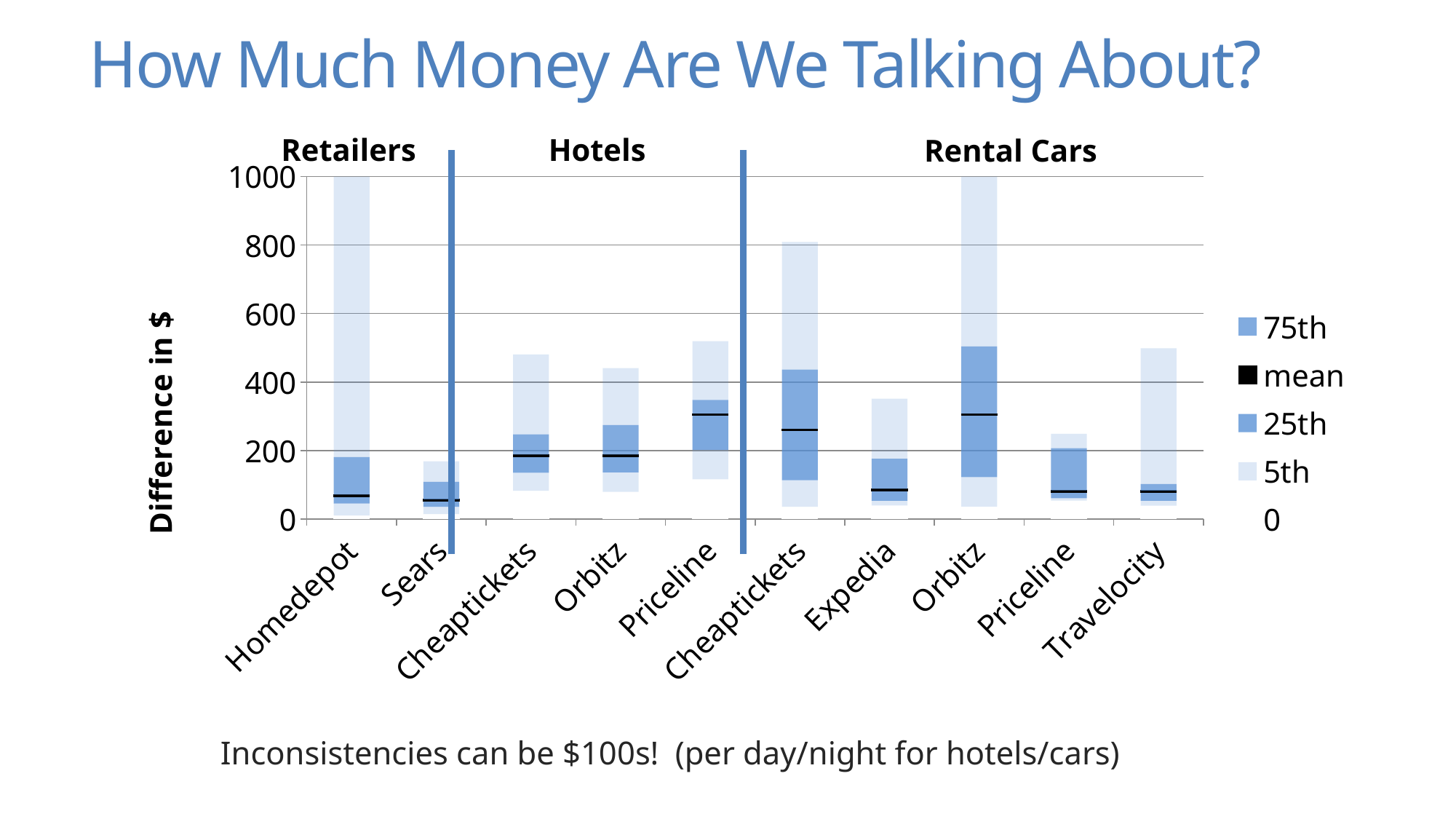
What are the three group labels shown above the chart? Retailers, Hotels, Rental Cars What kind of chart is shown on the slide? bar chart Within the Hotels group, which category has the tallest bar? Priceline Is the top of the bar for Cheaptickets in the Rental Cars group greater or less than 600? greater How many categories are plotted along the x axis of the chart? 10 Is the top of the bar for Sears greater or less than 200? less Is the mean line for Orbitz in the Rental Cars group greater or less than 200? greater What is the title of the y axis of the chart? Difference in $ Which category has the lowest bar top on the chart? Sears